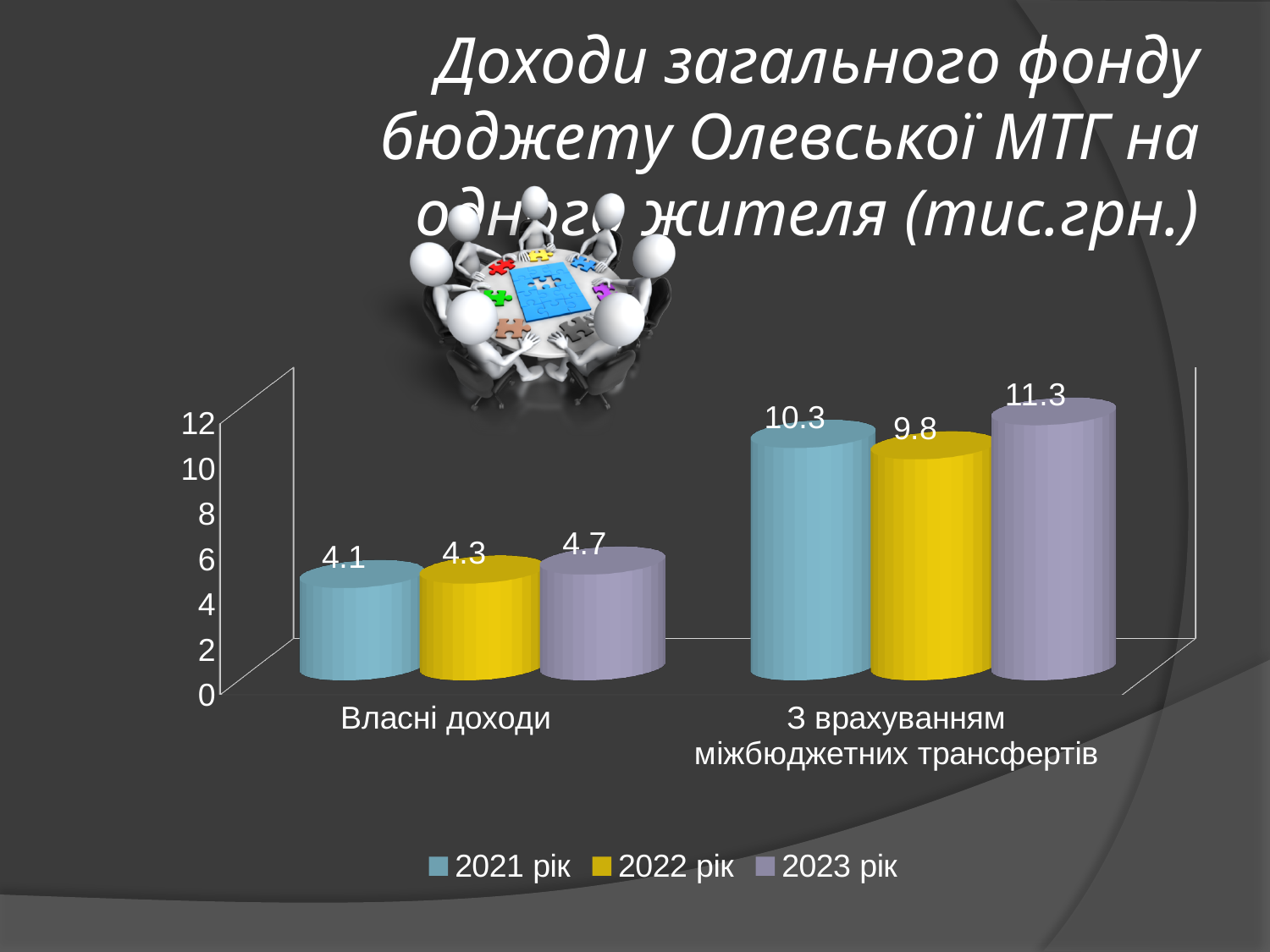
Is the value for 2023 рік in the З врахуванням міжбюджетних трансфертів category greater or less than 10? greater What kind of chart is shown on the slide? bar chart Which year has the lowest value in the Власні доходи category? 2021 рік How many categories are shown on the x axis? 2 Which is larger in the З врахуванням міжбюджетних трансфертів category: the 2021 рік value or the 2022 рік value? 2021 рік What is the value for 2021 рік in the Власні доходи category? 4.1 What is the difference between the 2023 рік and 2021 рік values in the Власні доходи category? 0.6 What is the value for 2022 рік in the Власні доходи category? 4.3 What is the value for 2023 рік in the З врахуванням міжбюджетних трансфертів category? 11.3 Which series is shown in yellow? 2022 рік How many series does the legend list? 3 Which year has the highest value in the З врахуванням міжбюджетних трансфертів category? 2023 рік